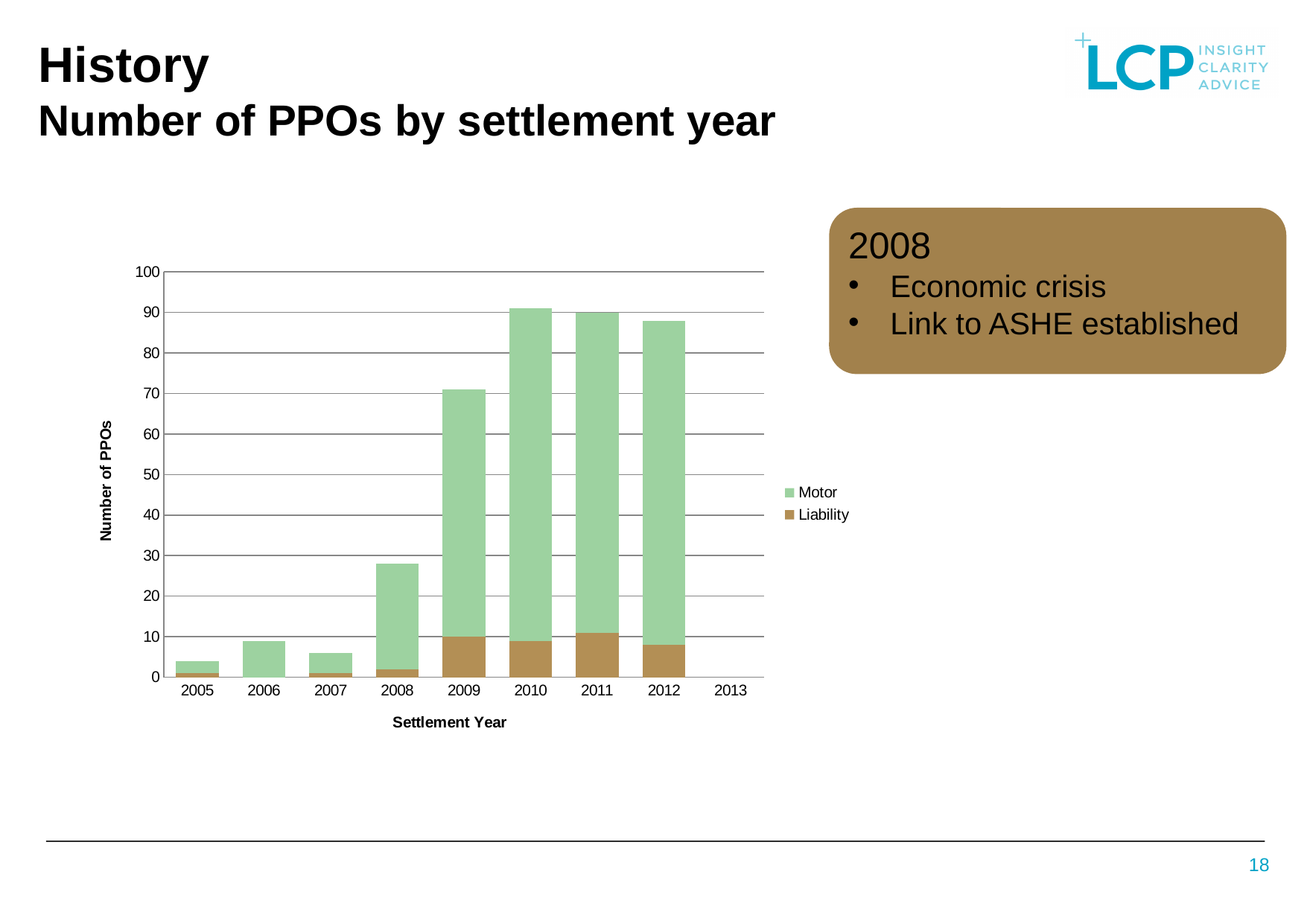
Is the total number of PPOs for 2012 greater or less than 80? greater Which settlement year has the larger total number of PPOs, 2006 or 2007? 2006 Is the total number of PPOs for 2005 greater or less than 10? less What kind of chart is shown on the slide? Stacked bar chart Which settlement year has the larger total number of PPOs, 2008 or 2009? 2009 How many series does the legend list? 2 Which two series are listed in the legend? Motor and Liability Is the total number of PPOs for 2009 greater or less than 60? greater What is the label of the y axis? Number of PPOs How many settlement years are shown on the x axis? 9 Does the total number of PPOs generally rise or fall from 2005 to 2010? rise